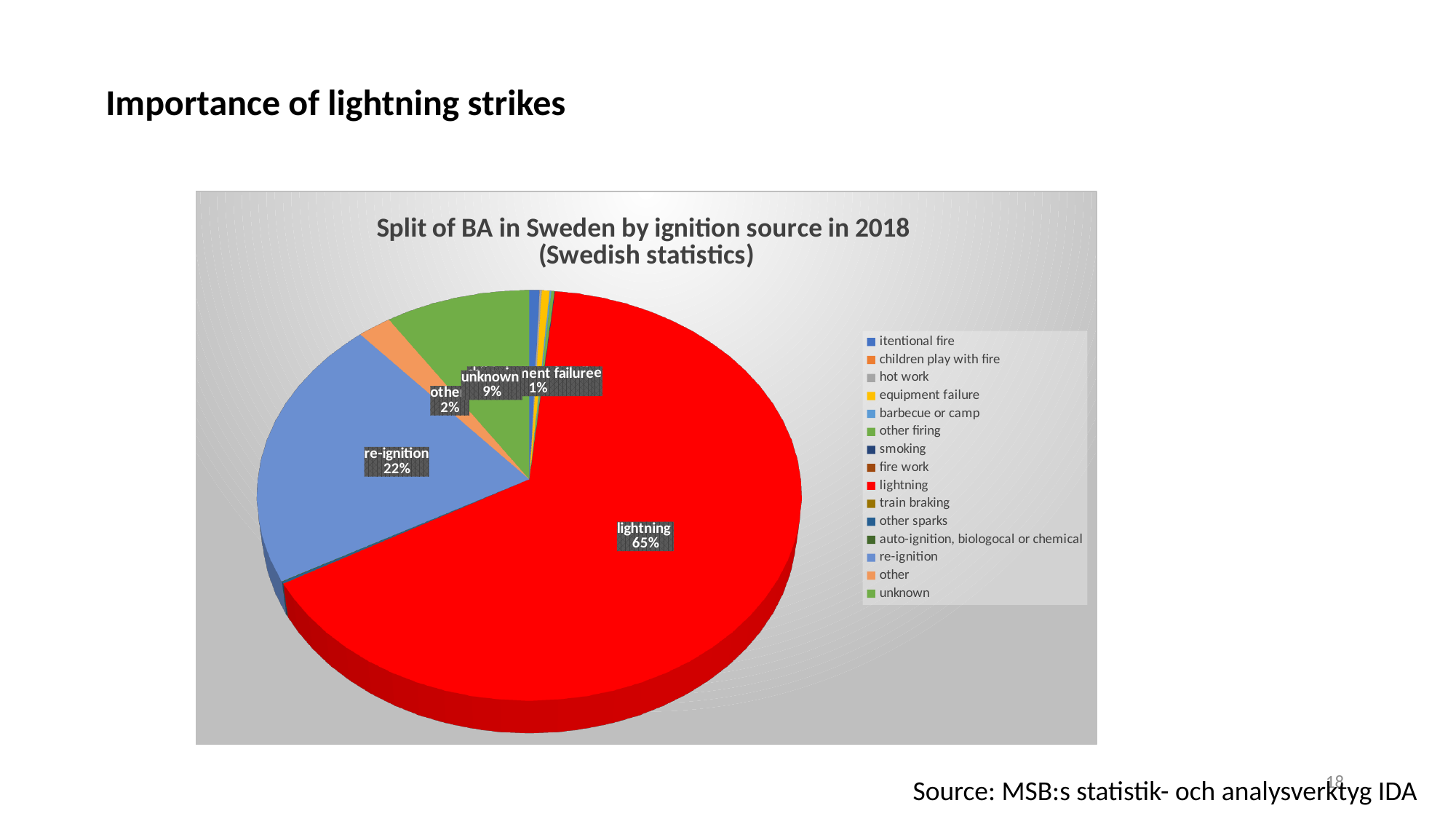
What is the title of the chart? Split of BA in Sweden by ignition source in 2018 (Swedish statistics) What percentage is shown for unknown? 9% Which slice is larger, re-ignition or unknown? re-ignition What kind of chart is shown on the slide? pie chart What percentage is shown for re-ignition? 22% By how many percentage points does lightning exceed re-ignition? 43 percentage points How many ignition sources are listed in the legend? 15 What share of the pie does lightning account for? 65% What percentage is shown for the 'other' slice? 2% Which ignition source has the largest slice of the pie? lightning By how many percentage points does unknown exceed other? 7 percentage points What colour is the lightning slice? red